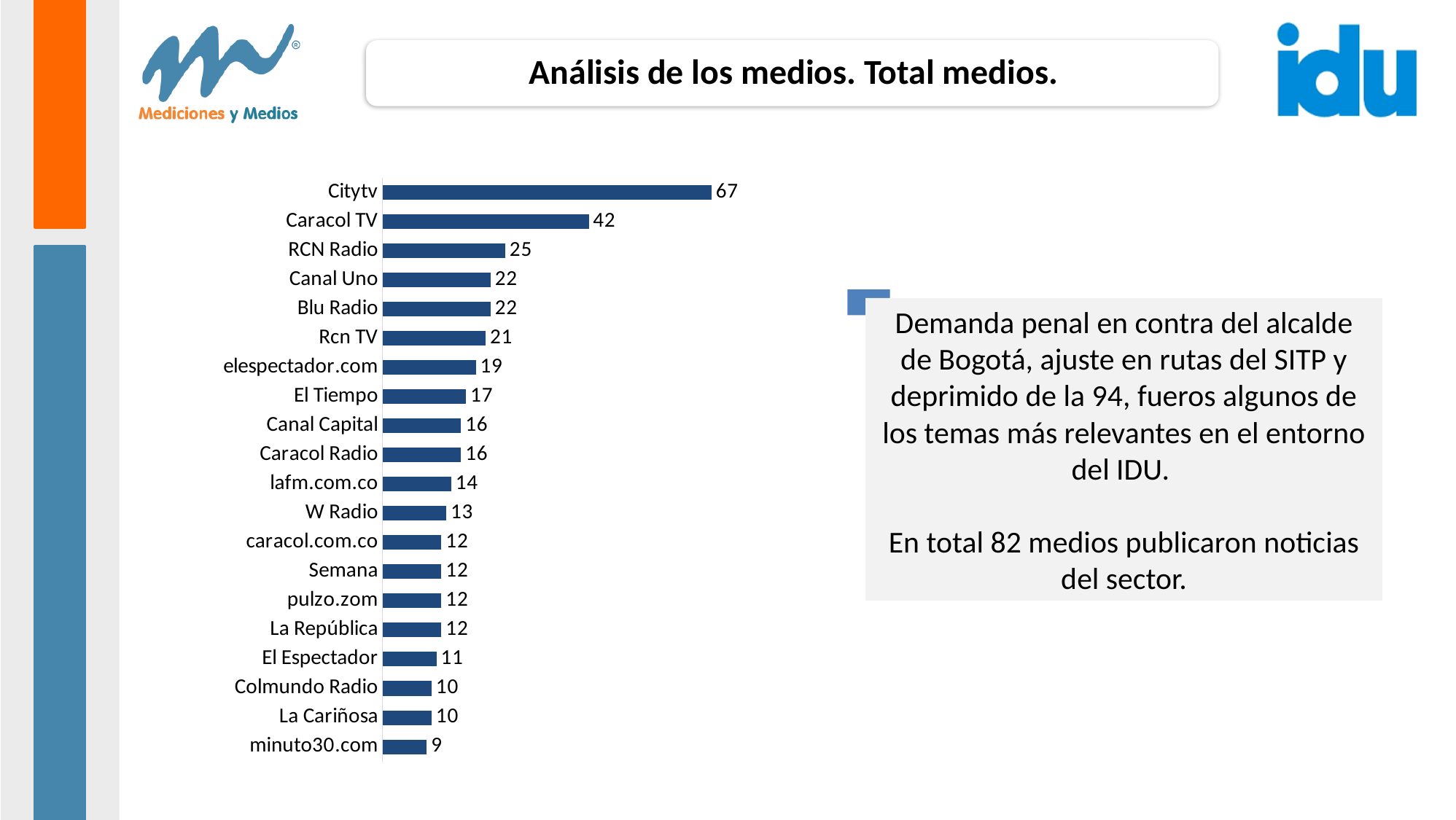
What is the title shown at the top of the slide? Análisis de los medios. Total medios. How many media outlets are shown in the chart? 20 Which media outlet has the highest value? Citytv What is the difference between the values for Rcn TV and W Radio? 8 What is the value for Citytv? 67 What kind of chart is shown on the slide? Bar chart Which is larger, the value for Caracol TV or the value for Canal Uno? Caracol TV What is the value for El Tiempo? 17 What is the value for minuto30.com? 9 What is the value for RCN Radio? 25 What is the difference between the values for Citytv and Caracol TV? 25 Which media outlet has the lowest value? minuto30.com